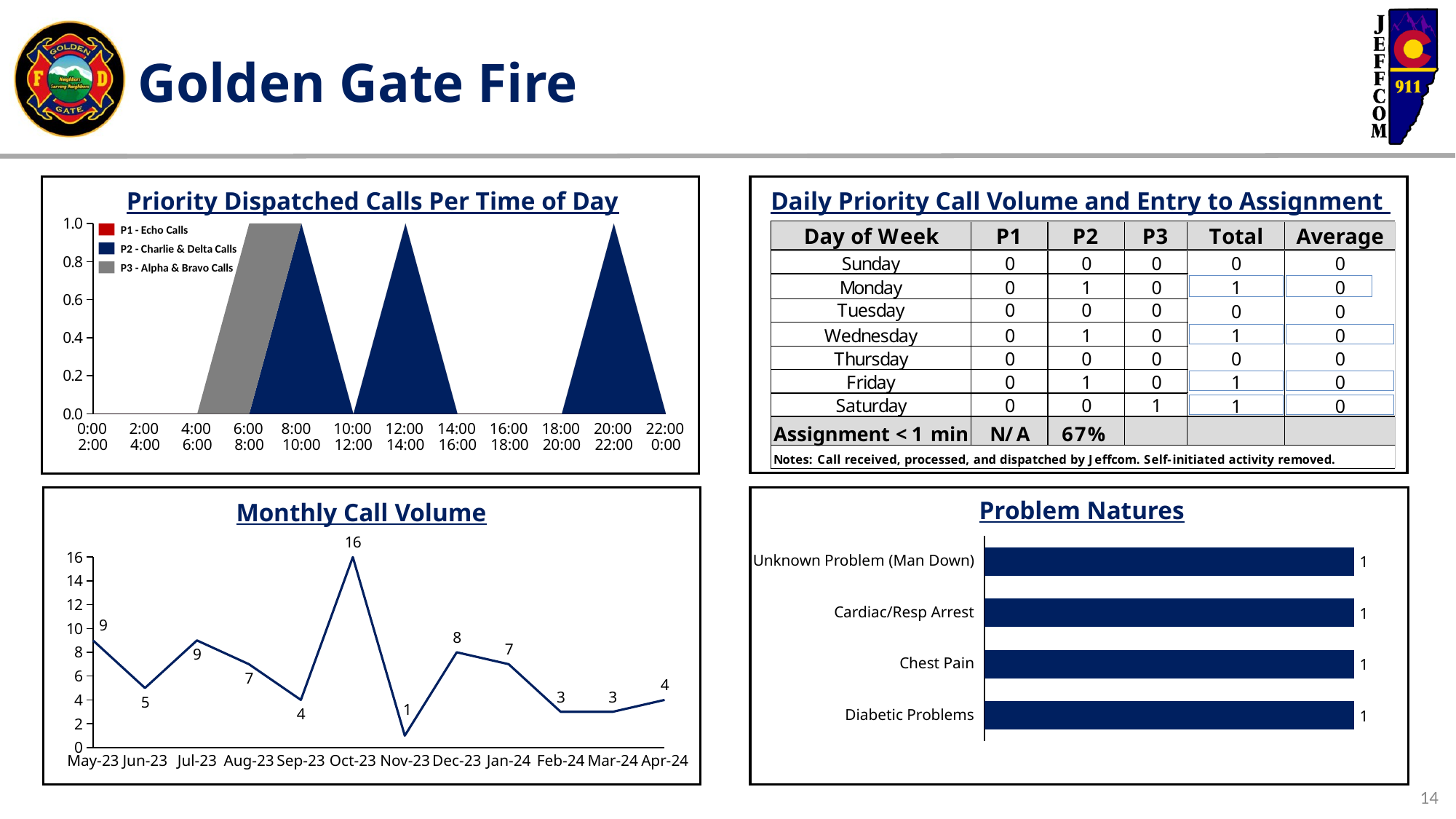
In the Priority Dispatched Calls Per Time of Day chart, how many series does the legend list? 3 In the Monthly Call Volume chart, do the values rise or fall from Dec-23 to Feb-24? Fall In the Monthly Call Volume chart, which month has the highest call volume? Oct-23 In the Monthly Call Volume chart, what is the difference between the values for Oct-23 and Nov-23? 15 What kind of chart is the Problem Natures chart? Bar chart In the Monthly Call Volume chart, what is the value for Oct-23? 16 In the Monthly Call Volume chart, which month has the lowest call volume? Nov-23 In the Problem Natures chart, how many problem categories are shown? 4 In the Monthly Call Volume chart, which is larger, the value for Dec-23 or the value for Jan-24? Dec-23 In the Monthly Call Volume chart, how many months are plotted? 12 In the Problem Natures chart, what is the value for Chest Pain? 1 What kind of chart is the Monthly Call Volume chart? Line chart